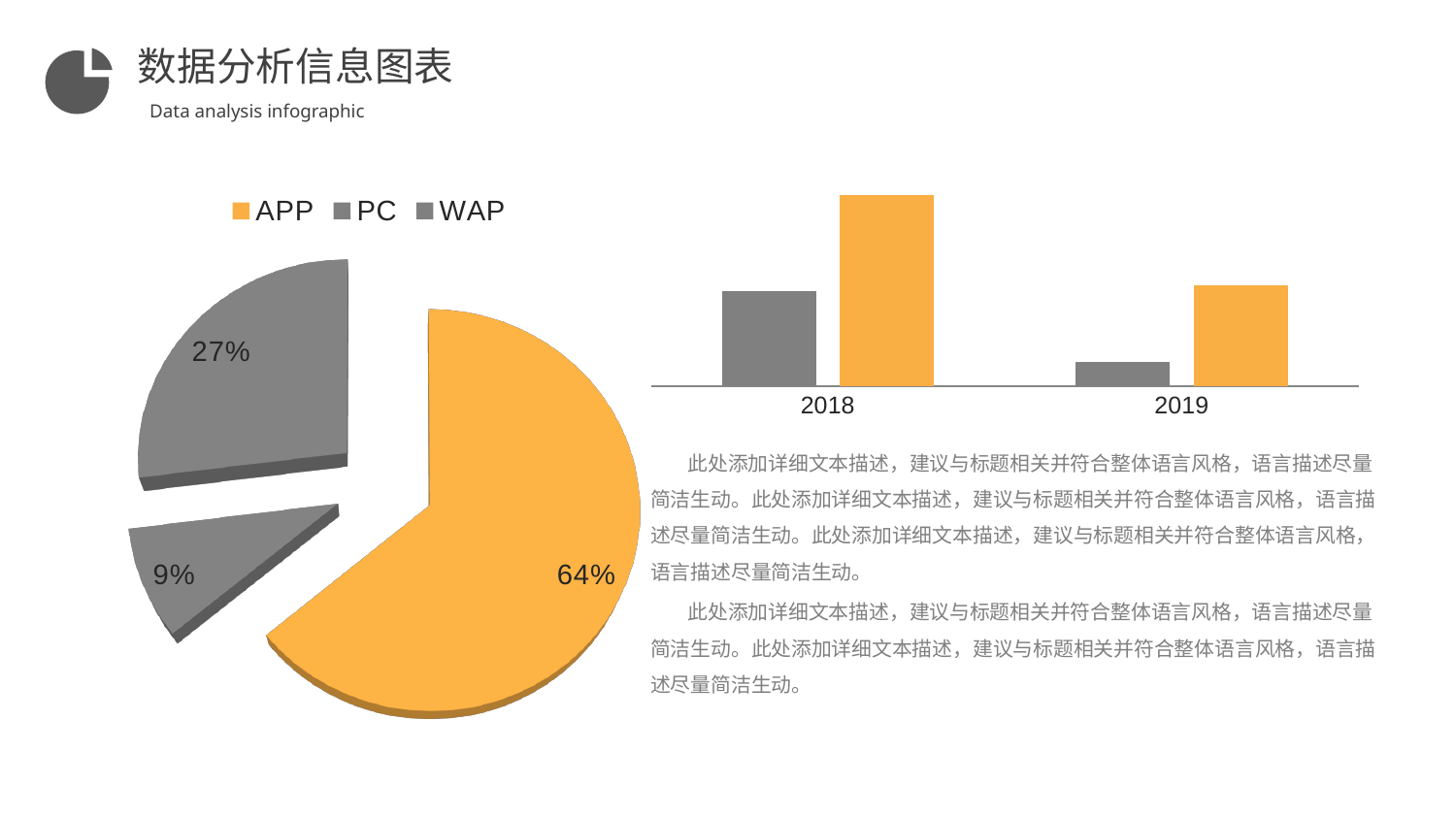
In the bar chart on the right, is the orange bar taller for 2018 or for 2019? 2018 How many entries does the legend of the pie chart on the left list? 3 In the pie chart on the left, what is the smallest percentage shown on any slice? 9% In the pie chart on the left, what colour is the APP slice? Orange How many slices does the pie chart on the left have? 3 What kind of chart is the chart on the left of the slide? Pie chart How many categories are shown on the x axis of the bar chart on the right? 2 In the pie chart on the left, what is the difference in percentage points between the largest slice (64%) and the 27% slice? 37 What kind of chart is the chart on the right of the slide? Bar chart In the pie chart on the left, what percentage is shown for APP? 64% In the pie chart on the left, which legend category has the largest slice? APP In the bar chart on the right, do the bar values rise or fall from 2018 to 2019? Fall